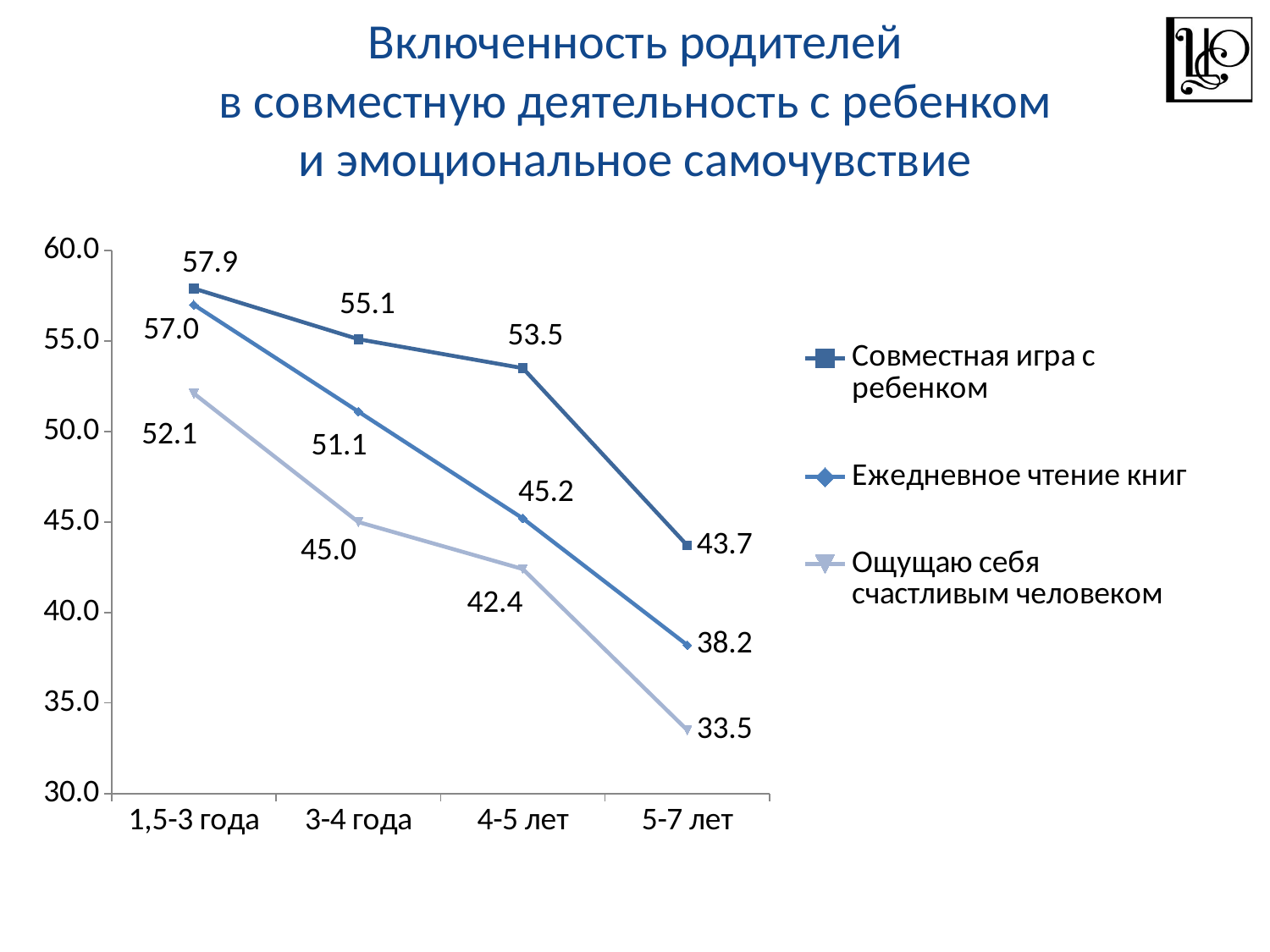
What is the value for 'Совместная игра с ребенком' at '1,5-3 года'? 57.9 What is the value for 'Ощущаю себя счастливым человеком' at '5-7 лет'? 33.5 How many series does the legend list? 3 For which age group is the value of 'Ощущаю себя счастливым человеком' the lowest? 5-7 лет Which is larger at '3-4 года': 'Ежедневное чтение книг' or 'Ощущаю себя счастливым человеком'? Ежедневное чтение книг What is the difference between the 'Совместная игра с ребенком' values at '1,5-3 года' and '5-7 лет'? 14.2 Do the values of 'Ежедневное чтение книг' rise or fall from '1,5-3 года' to '5-7 лет'? fall What is the value for 'Ежедневное чтение книг' at '4-5 лет'? 45.2 Which series is shown with triangle markers in the legend? Ощущаю себя счастливым человеком What type of chart is shown on the slide? line chart For which age group is the value of 'Совместная игра с ребенком' the highest? 1,5-3 года How many age categories are shown on the x axis? 4